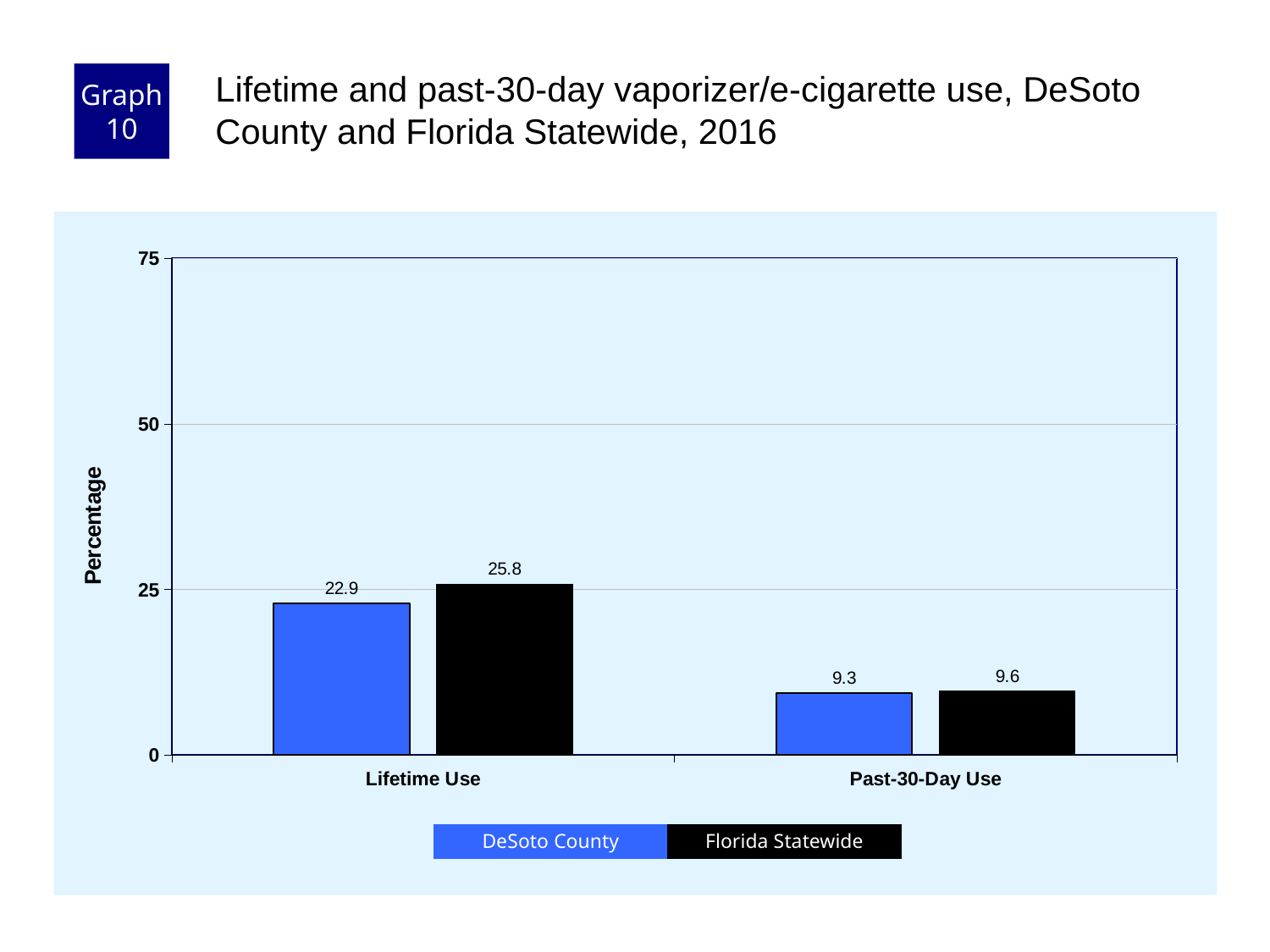
Which bar has the highest value on the chart? Florida Statewide, Lifetime Use What is the difference between the Florida Statewide and DeSoto County values for Lifetime Use? 2.9 Is the Florida Statewide value for Lifetime Use greater or less than 25? greater How many categories are shown on the x axis? 2 What is the Florida Statewide value for Lifetime Use? 25.8 What kind of chart is shown on the slide? bar chart What is the DeSoto County value for Lifetime Use? 22.9 For Lifetime Use, which is larger: DeSoto County or Florida Statewide? Florida Statewide What is the Florida Statewide value for Past-30-Day Use? 9.6 Which bar has the lowest value on the chart? DeSoto County, Past-30-Day Use How many series does the legend list? 2 What is the DeSoto County value for Past-30-Day Use? 9.3